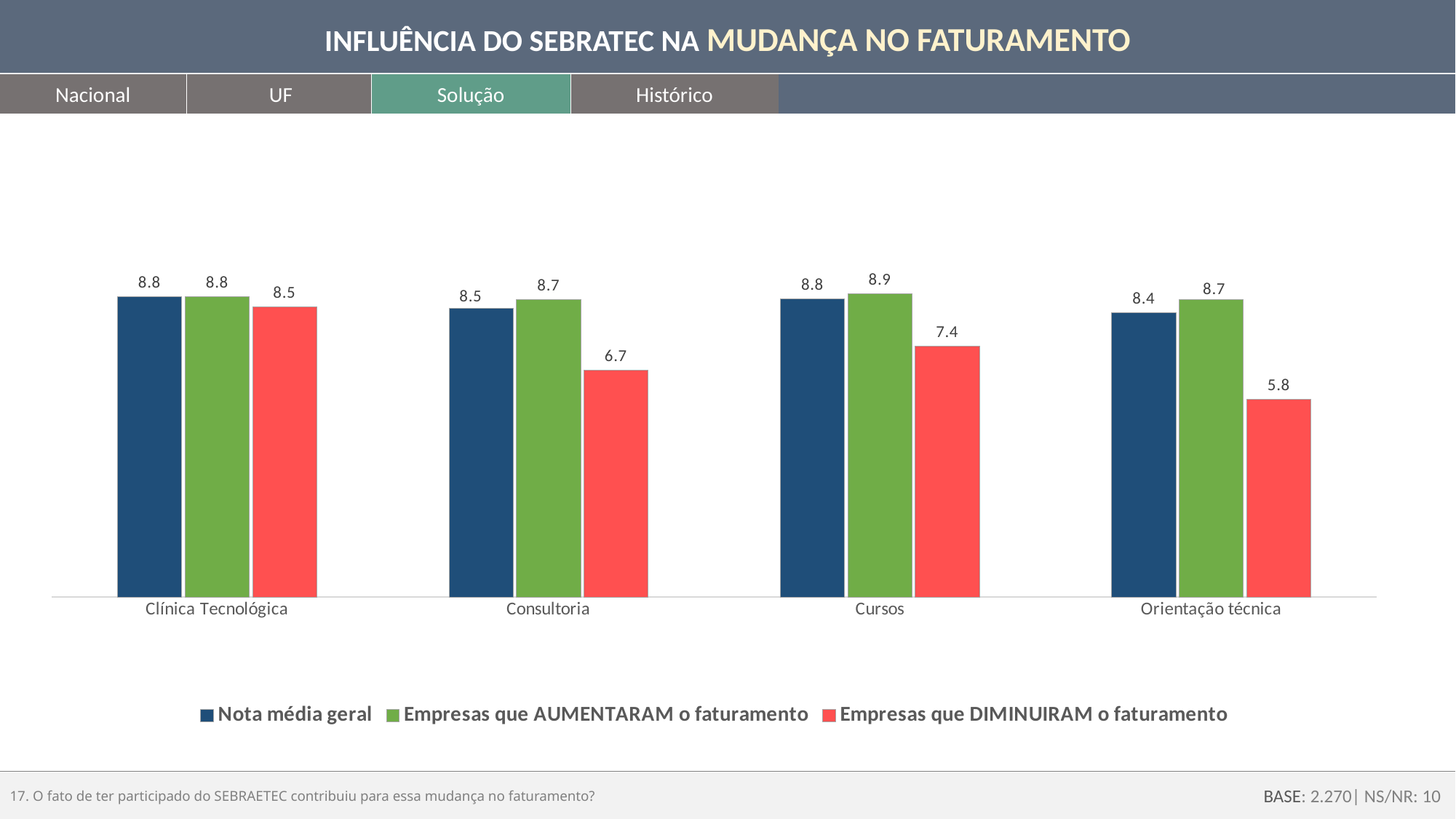
What kind of chart is shown on the slide? Bar chart Which category has the highest value for 'Empresas que AUMENTARAM o faturamento'? Cursos What is the value of 'Empresas que AUMENTARAM o faturamento' for Cursos? 8.9 How many series does the legend list? 3 Does the value for 'Empresas que DIMINUIRAM o faturamento' rise or fall from Cursos to Orientação técnica? Fall Which is larger for Cursos: 'Nota média geral' or 'Empresas que DIMINUIRAM o faturamento'? Nota média geral How many categories are shown on the x axis? 4 What is the value of 'Empresas que DIMINUIRAM o faturamento' for Orientação técnica? 5.8 What is the difference between 'Nota média geral' and 'Empresas que DIMINUIRAM o faturamento' for Consultoria? 1.8 Which category has the lowest value for 'Empresas que DIMINUIRAM o faturamento'? Orientação técnica What is the difference between 'Empresas que AUMENTARAM o faturamento' and 'Empresas que DIMINUIRAM o faturamento' for Orientação técnica? 2.9 What is the value of 'Nota média geral' for Consultoria? 8.5